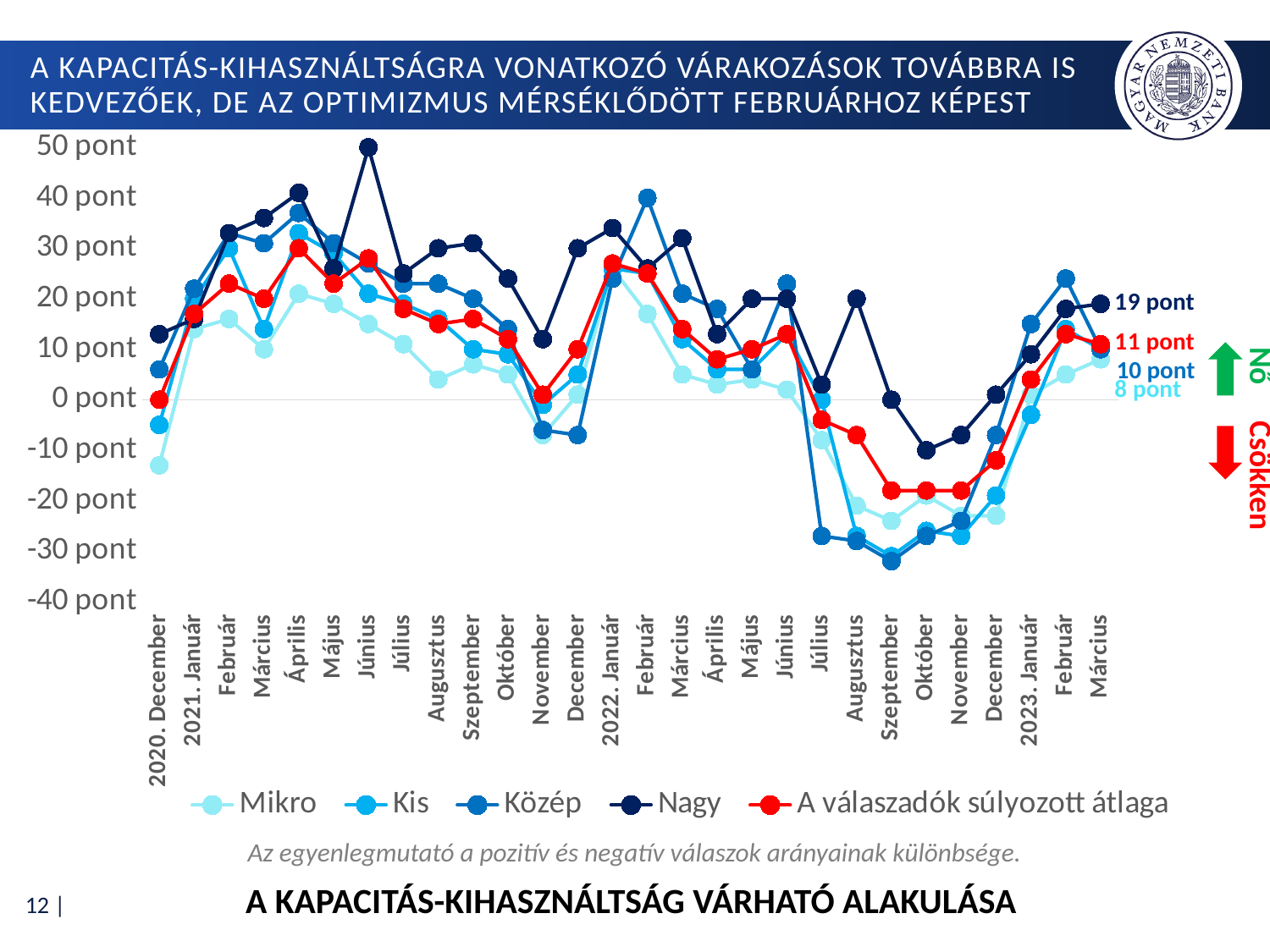
Is the value of the Nagy series in 2021. Június greater or less than 40 pont? greater How many series does the legend list? 5 What is the value of the Mikro series in 2023. Március? 8 pont Does 'A válaszadók súlyozott átlaga' rise or fall from 2022. Szeptember to 2023. Február? rise Is the value of 'A válaszadók súlyozott átlaga' in 2022. Szeptember greater or less than -10 pont? less In 2023. Március, which is larger: the Nagy value or the Mikro value? Nagy What is the value of the Nagy series in 2023. Március? 19 pont In 2023. Március, what is the difference between the Nagy value and the Mikro value? 11 pont How many months are shown on the x axis? 28 What type of chart is shown on the slide? line chart What is the value of 'A válaszadók súlyozott átlaga' in 2023. Március? 11 pont In which month does the Nagy series reach its highest value? 2021. Június